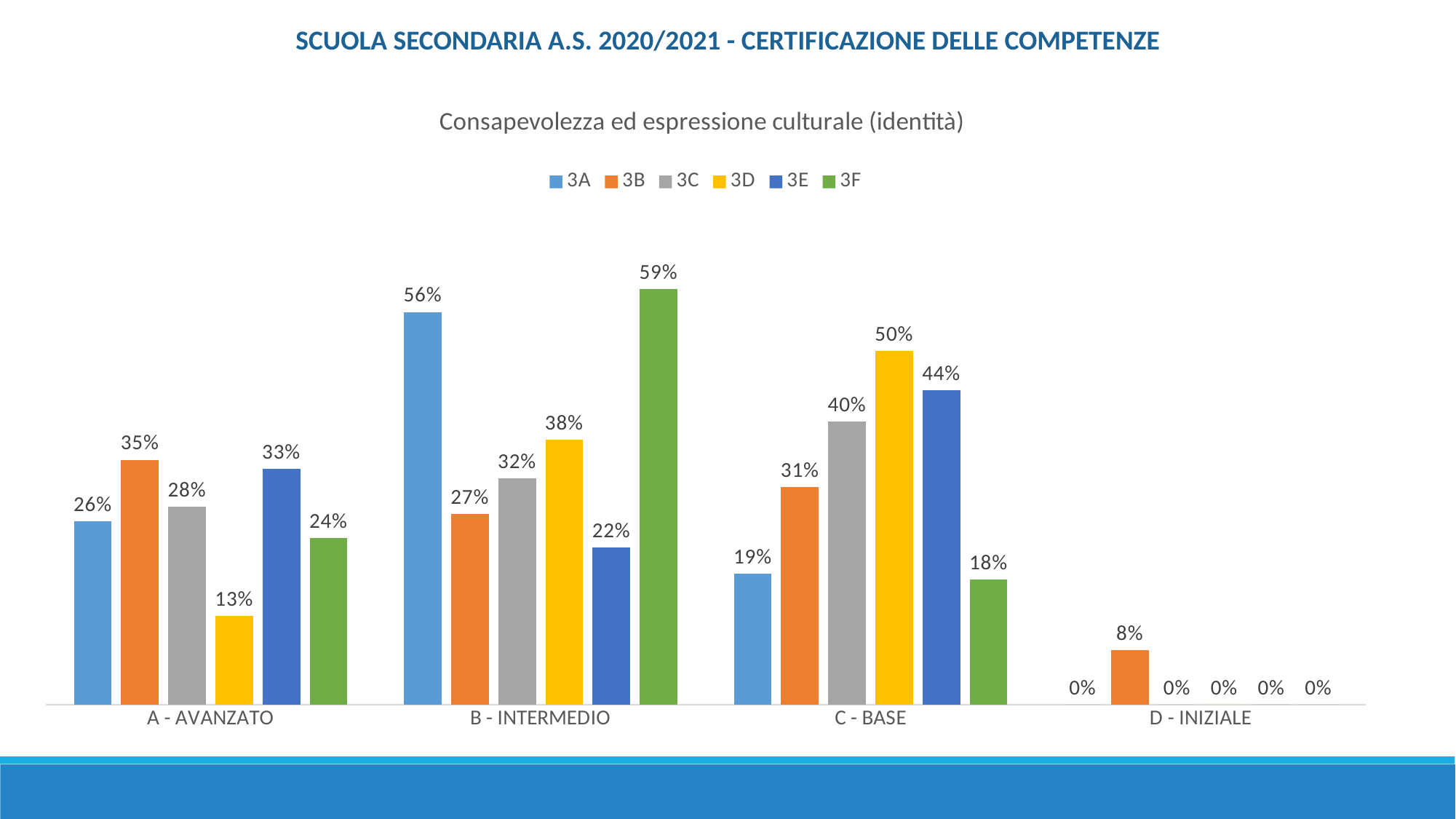
What kind of chart is shown on the slide? Bar chart What is the value for 3B in the D - INIZIALE category? 8% What is the difference between the 3F value and the 3E value in the B - INTERMEDIO category? 37% What is the value for 3D in the A - AVANZATO category? 13% Which series has the highest value in the C - BASE category? 3D What is the title of the chart? Consapevolezza ed espressione culturale (identità) What is the value for 3A in the B - INTERMEDIO category? 56% Which is larger in the A - AVANZATO category: the value for 3B or the value for 3E? 3B Which colour represents the 3F series in the legend? Green How many categories are shown on the x axis? 4 How many series does the legend list? 6 Which series has the lowest value in the B - INTERMEDIO category? 3E